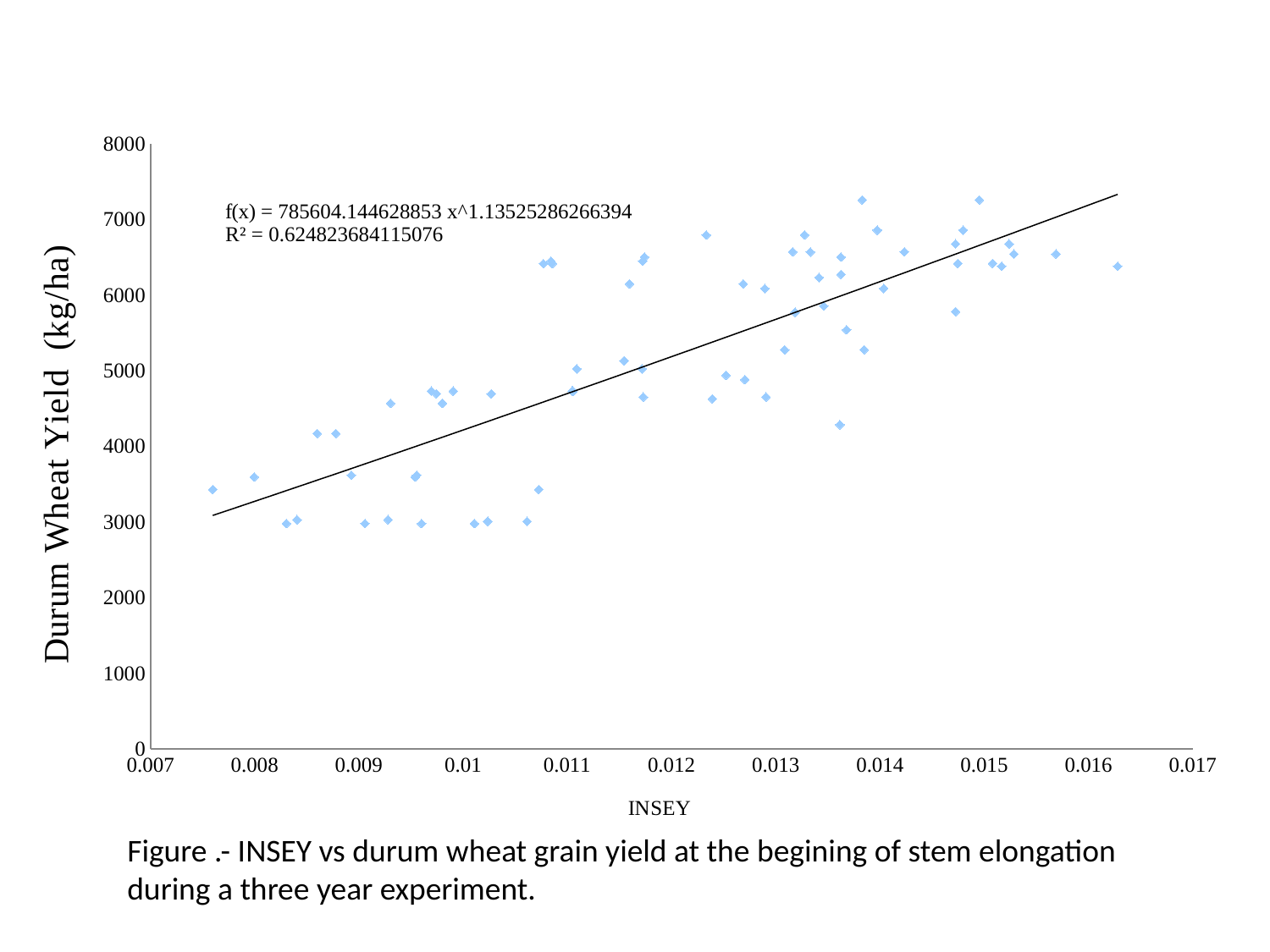
Is the lowest plotted yield greater or less than 2000? greater What is the title of the y axis? Durum Wheat Yield (kg/ha) Is the yield of the leftmost point (INSEY about 0.0076) greater or less than 4000? less Which has the larger yield, the rightmost point or the leftmost point? the rightmost point Is the lowest plotted yield greater or less than 3500? less Do the durum wheat yield values generally rise or fall as INSEY increases along the x axis? rise What kind of chart is shown on the slide? scatter plot What R² value is printed on the chart? 0.624823684115076